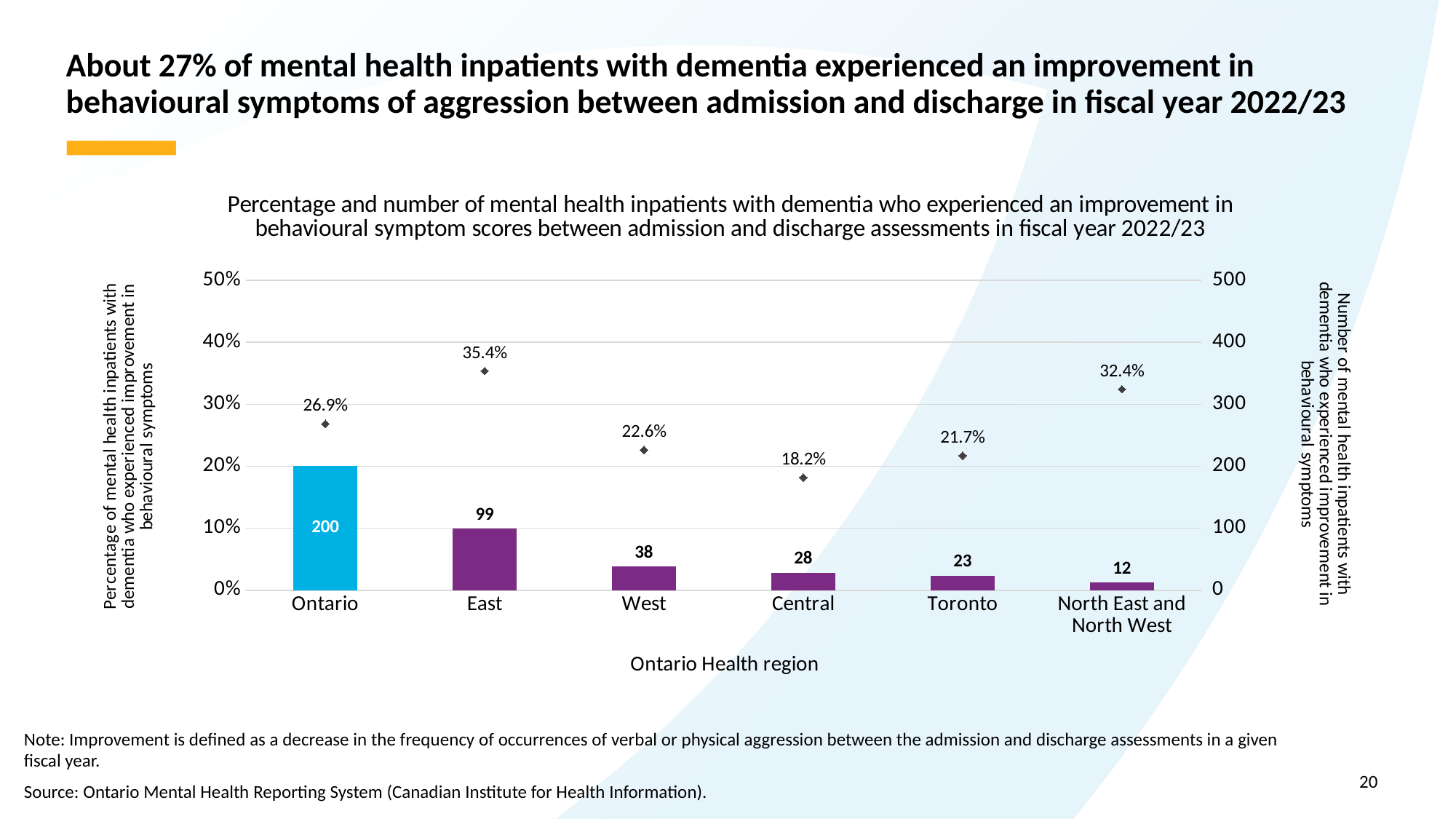
Which has a higher percentage of inpatients with improvement, Toronto or North East and North West? North East and North West What is the number of inpatients shown for the West region? 38 What is the label of the x axis? Ontario Health region What is the difference in percentage points between the East region and the Central region? 17.2 Which region has the smallest number of inpatients who experienced an improvement? North East and North West Which region has the highest percentage of inpatients who experienced an improvement? East How many mental health inpatients with dementia in Ontario experienced an improvement in behavioural symptoms? 200 Which region has the lowest percentage of inpatients who experienced an improvement? Central What percentage of mental health inpatients with dementia in the East region experienced an improvement in behavioural symptoms? 35.4% How many more inpatients experienced an improvement in the East region than in the West region? 61 What is the percentage value shown for Toronto? 21.7% How many Ontario Health region categories are shown on the x axis? 6